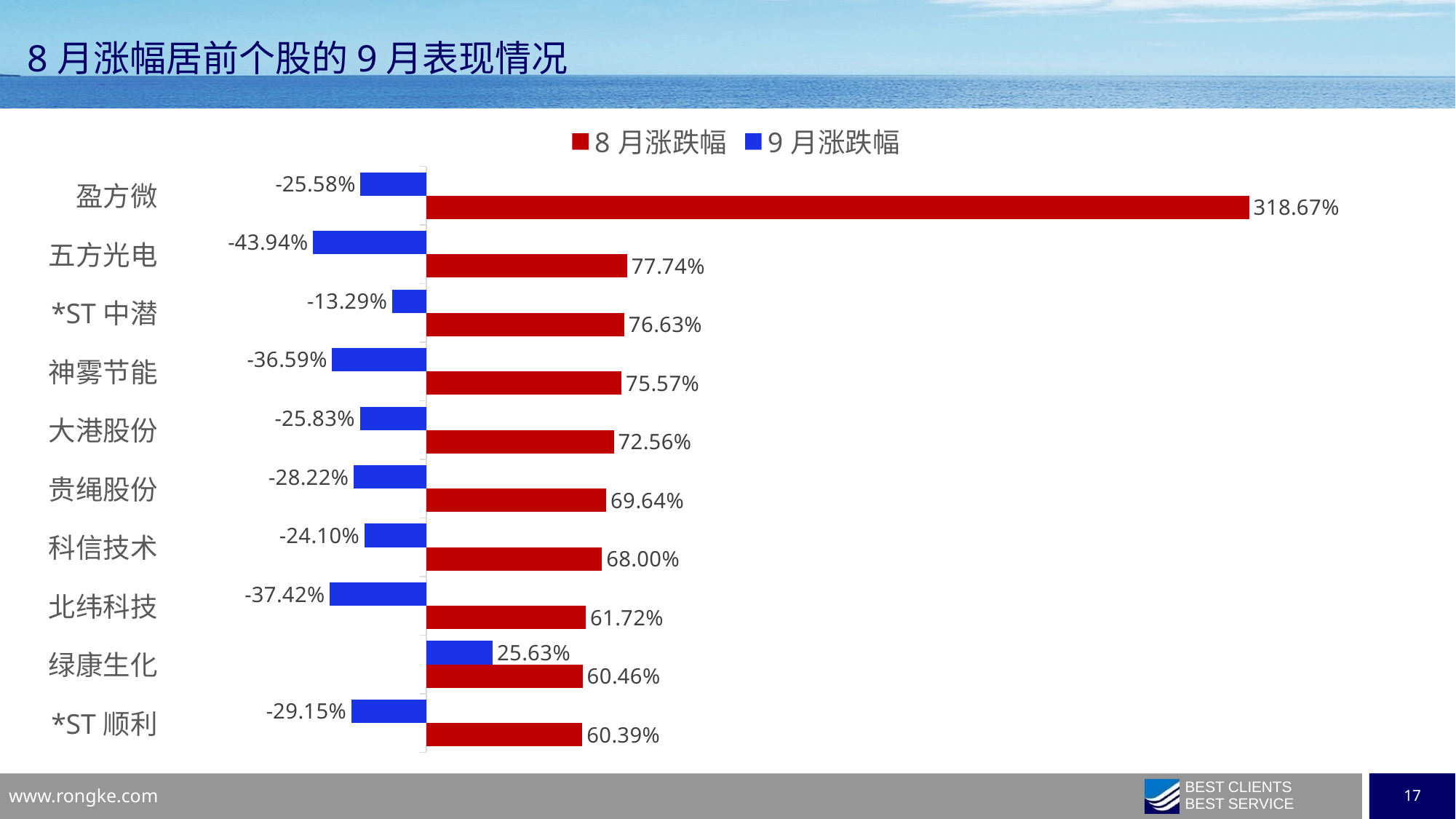
What is the 9 月涨跌幅 value for 五方光电? -43.94% What is the 8 月涨跌幅 value for 盈方微? 318.67% How many series does the legend list? 2 Which colour represents the 9 月涨跌幅 series? Blue What is the difference between the 8 月涨跌幅 of 五方光电 and that of *ST 中潜? 1.11% What kind of chart is shown on the slide? Bar chart Which stock has the lowest 8 月涨跌幅? *ST 顺利 Which stock has the lowest 9 月涨跌幅? 五方光电 Which is larger, the 8 月涨跌幅 of 大港股份 or that of 贵绳股份? 大港股份 How many stocks are shown in the chart? 10 What is the 9 月涨跌幅 value for 绿康生化? 25.63% Which stock has the highest 8 月涨跌幅? 盈方微